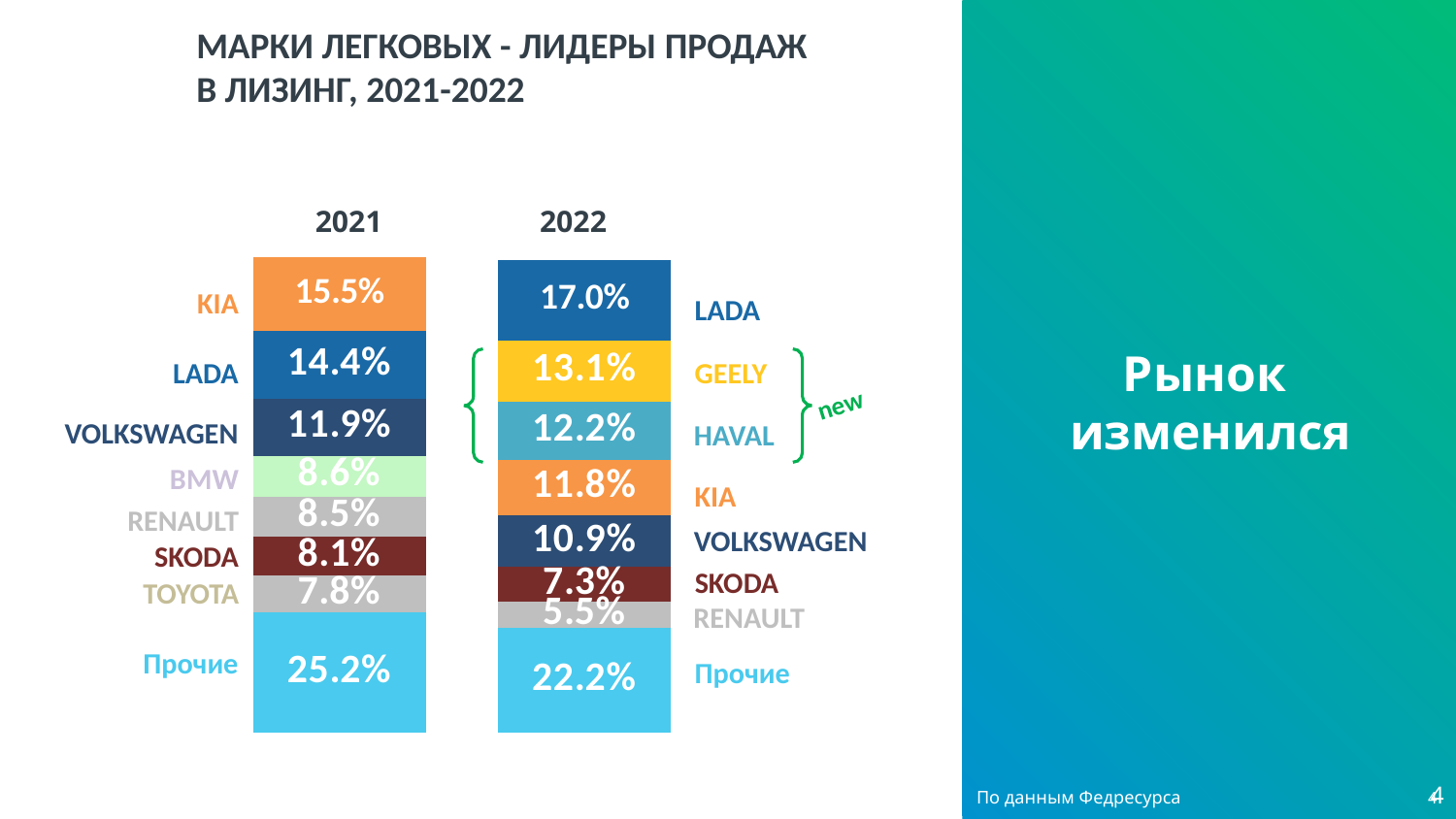
By how many percentage points did KIA's share fall from 2021 to 2022? 3.7 What is the share of LADA in the 2022 bar? 17.0% Which segment is the largest in the 2022 bar? Прочие What is the share of KIA in the 2021 bar? 15.5% Which two brands are marked as new in the 2022 bar? GEELY and HAVAL What is the difference between the 'Прочие' shares in 2021 and 2022? 3.0 percentage points What is the share of GEELY in 2022? 13.1% What type of chart is shown on the slide? Stacked bar chart Which named brand has the smallest share in 2022? RENAULT What is the share of TOYOTA in 2021? 7.8% How many segments does the 2022 bar contain? 8 Which is larger: VOLKSWAGEN's share in 2021 or in 2022? 2021